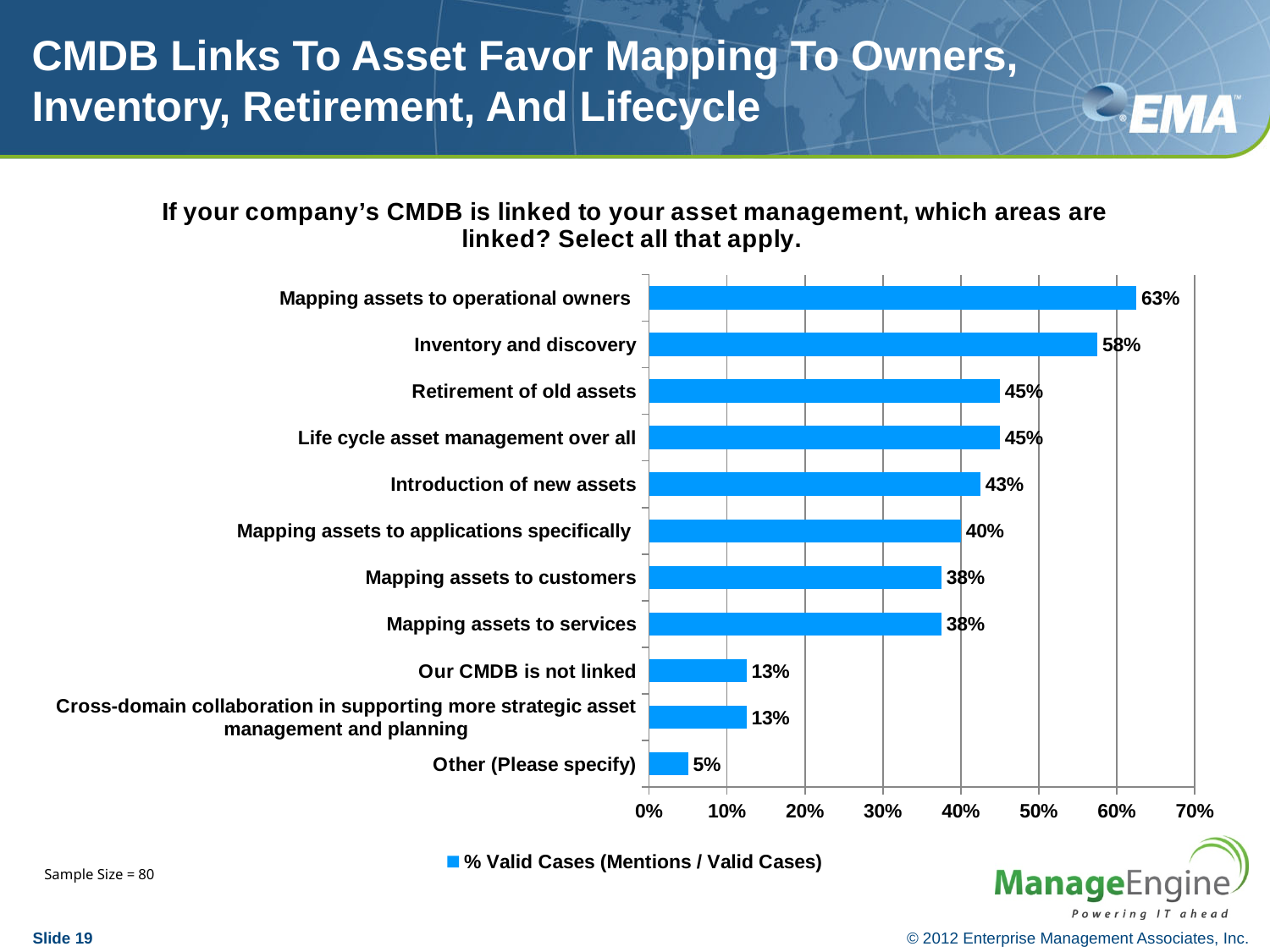
What is the difference between Mapping assets to operational owners and Inventory and discovery? 5% Which category has the highest value? Mapping assets to operational owners What is the legend entry for the series shown in the chart? % Valid Cases (Mentions / Valid Cases) Which category has the lowest value? Other (Please specify) How many categories are shown in the chart? 11 Which is larger, Mapping assets to applications specifically or Mapping assets to customers? Mapping assets to applications specifically What kind of chart is shown on the slide? Bar chart Is the value for Retirement of old assets greater or less than 40%? greater What is the difference between Introduction of new assets and Mapping assets to services? 5% What is the value for Our CMDB is not linked? 13% What is the value for Mapping assets to operational owners? 63% What is the value for Inventory and discovery? 58%